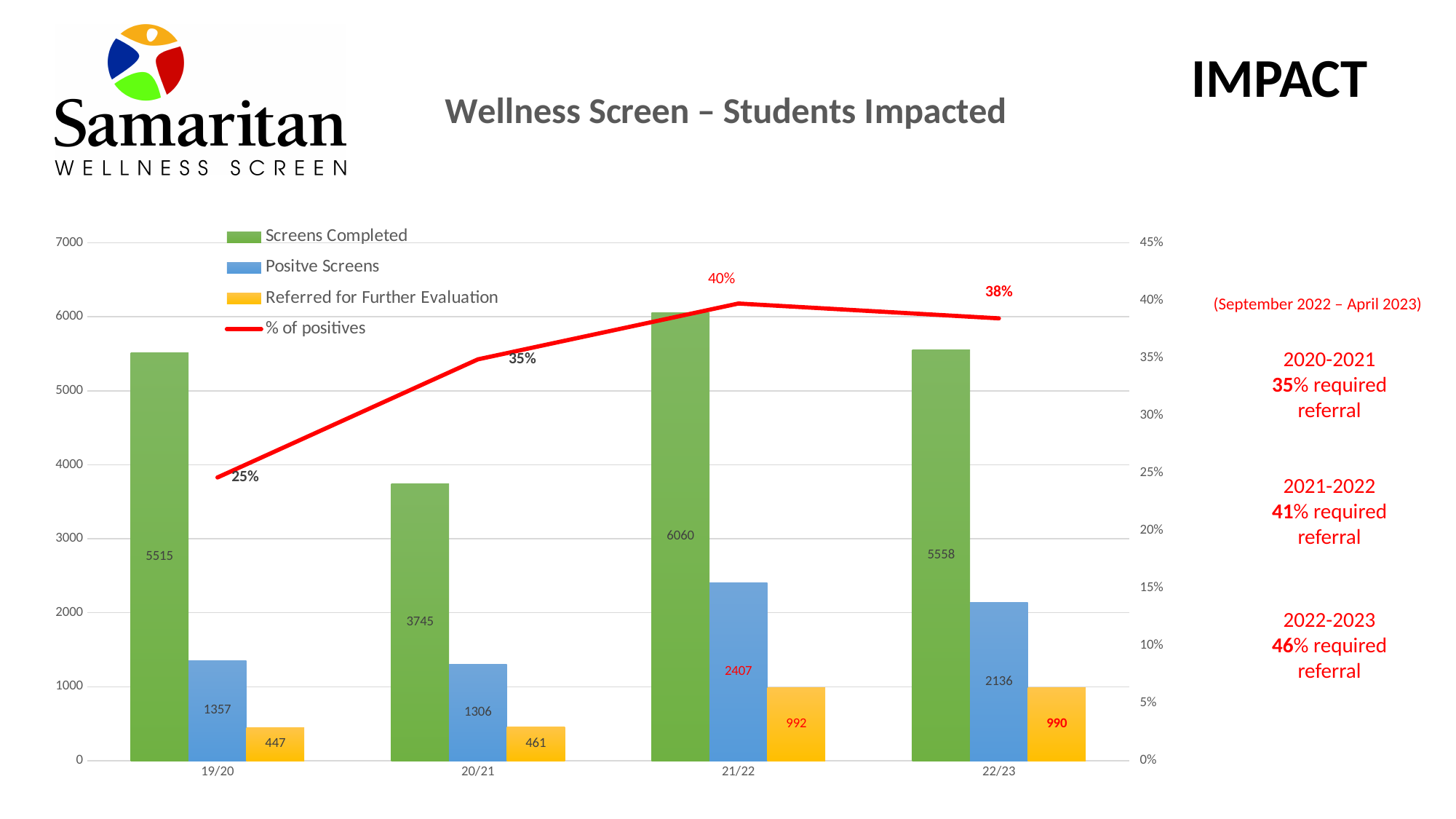
How many Screens Completed were there in 21/22? 6060 What is the value of Positive Screens for 19/20? 1357 How many years are shown on the x axis? 4 How many students were Referred for Further Evaluation in 22/23? 990 How many series does the legend list? 4 Which is larger: Positive Screens in 21/22 or in 22/23? 21/22 What is the % of positives for 20/21? 35% Which year has the highest number of Screens Completed? 21/22 Which year has the lowest number of Screens Completed? 20/21 What is the difference in Screens Completed between 21/22 and 20/21? 2315 Does the % of positives line rise or fall from 19/20 to 21/22? rise What kind of chart is used for the Screens Completed series? bar chart